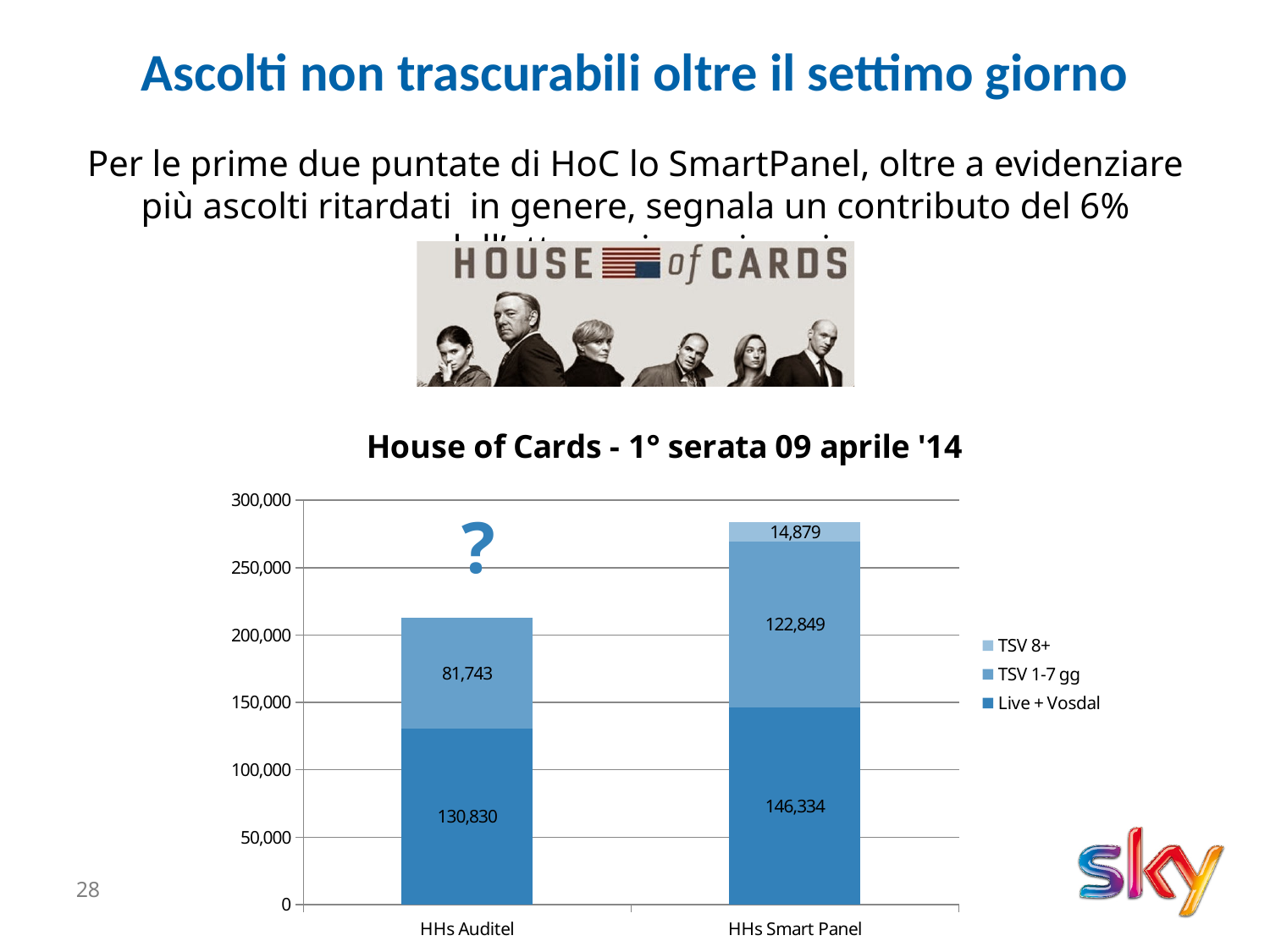
What type of chart is shown on the slide? Stacked bar chart What is the TSV 1-7 gg value for HHs Smart Panel? 122,849 What is the TSV 8+ value for HHs Smart Panel? 14,879 Which category has the larger Live + Vosdal value, HHs Auditel or HHs Smart Panel? HHs Smart Panel Is the total of the HHs Auditel bar greater or less than 250,000? less What is the total of the stacked bar for HHs Smart Panel? 284,062 What is the difference between the Live + Vosdal values for HHs Smart Panel and HHs Auditel? 15,504 What is the title of the chart? House of Cards - 1° serata 09 aprile '14 How many categories are shown on the x axis of the chart? 2 What is the Live + Vosdal value for HHs Auditel? 130,830 What is the TSV 1-7 gg value for HHs Auditel? 81,743 How many series does the chart legend list? 3